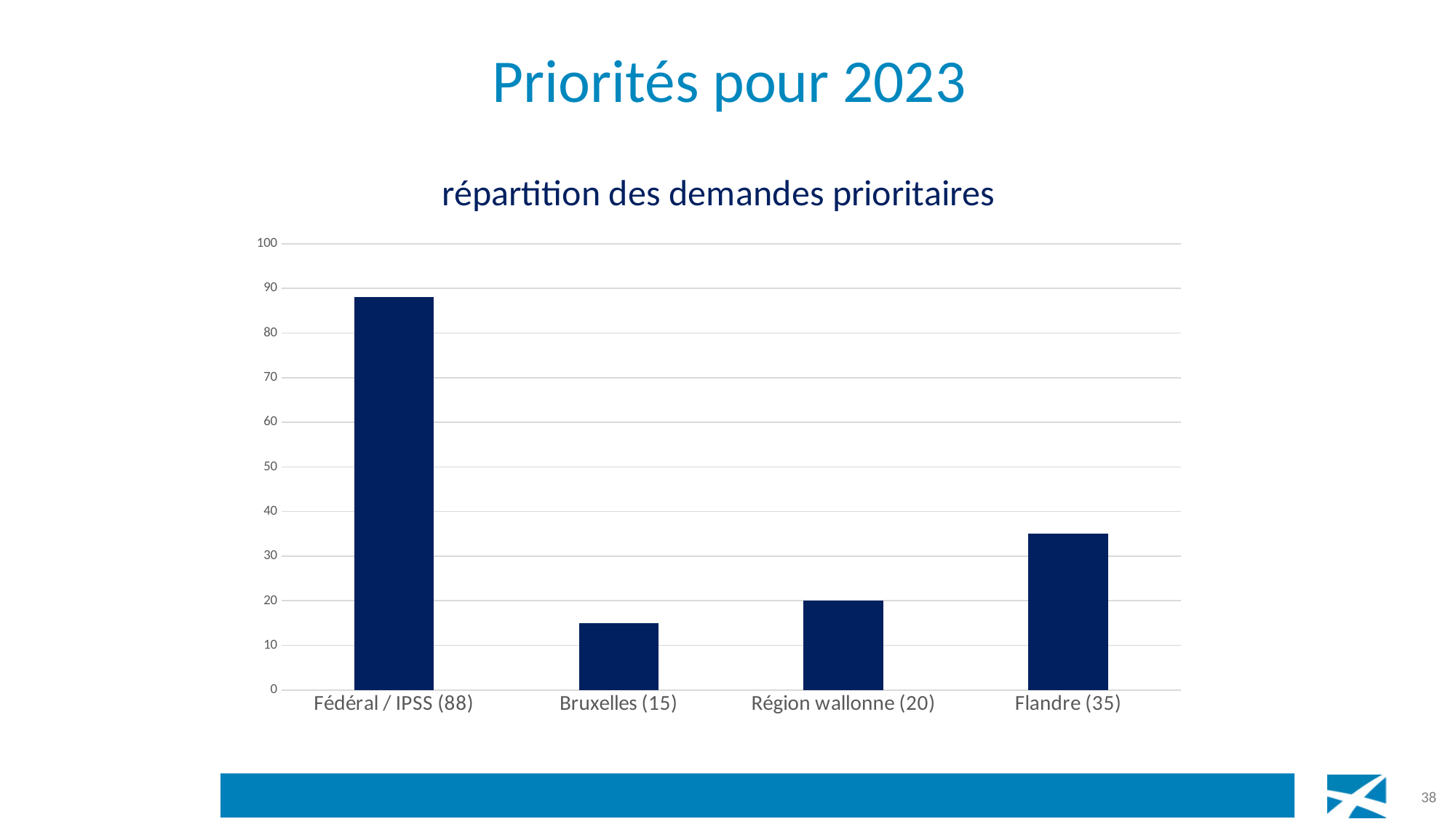
What is the value for Flandre? 35 What is the value for Fédéral / IPSS in the chart 'répartition des demandes prioritaires'? 88 What is the difference between the values for Fédéral / IPSS and Flandre? 53 Which is larger, the value for Région wallonne or the value for Bruxelles? Région wallonne Which category has the highest value? Fédéral / IPSS Which category has the lowest value? Bruxelles How many categories are shown in the chart? 4 What is the value for Région wallonne? 20 What is the title of the chart? répartition des demandes prioritaires What kind of chart is shown on the slide? bar chart Is the value for Flandre greater or less than 30? greater What is the value for Bruxelles? 15